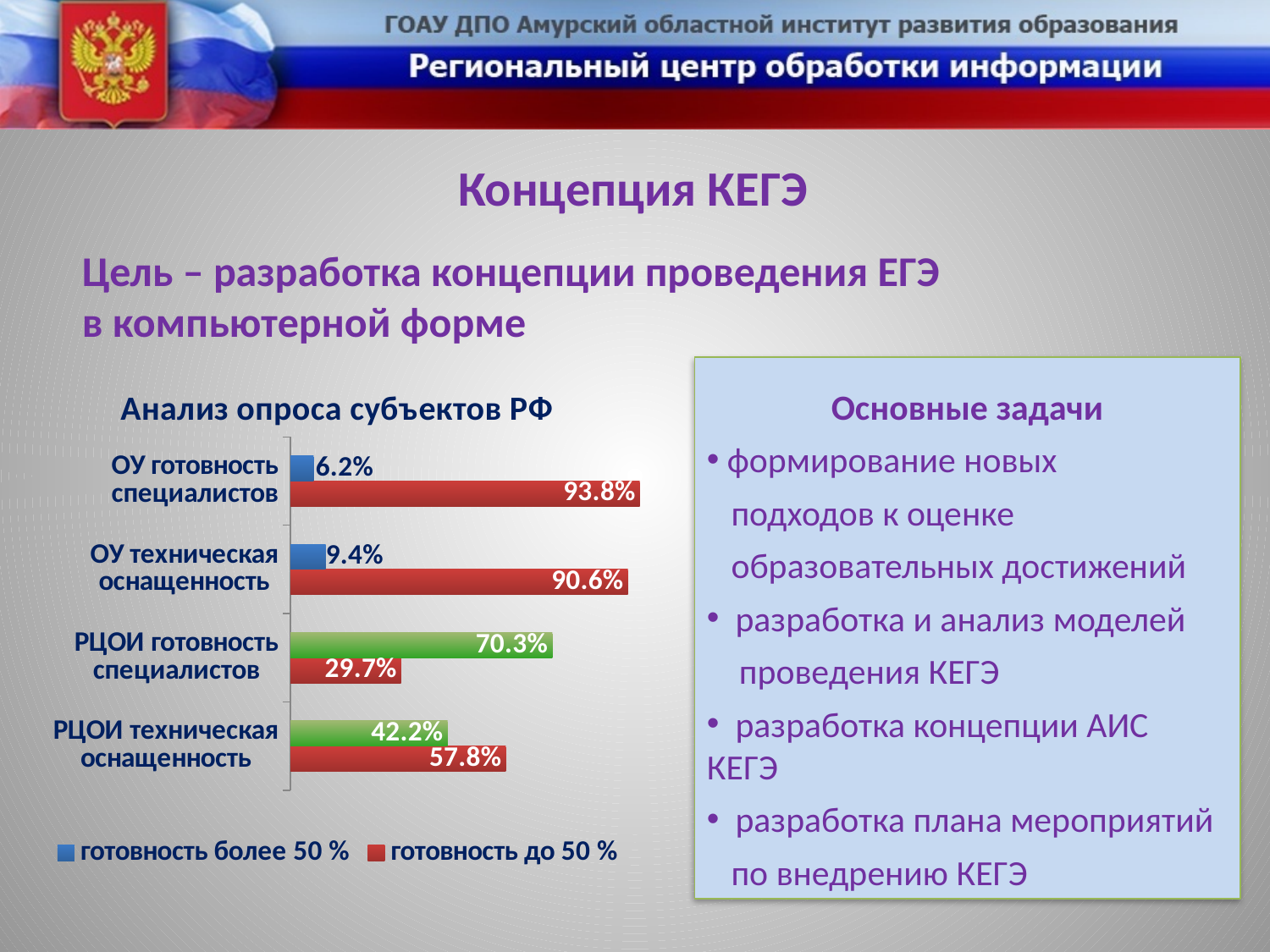
Which category has the highest value for "готовность до 50 %"? ОУ готовность специалистов Which is larger for "РЦОИ готовность специалистов": the "готовность более 50 %" value or the "готовность до 50 %" value? готовность более 50 % What colour is the "готовность до 50 %" series in the legend? red Which category has the lowest value for "готовность более 50 %"? ОУ готовность специалистов What is the value of "готовность до 50 %" for "РЦОИ готовность специалистов"? 29.7% How many categories are shown in the chart "Анализ опроса субъектов РФ"? 4 What type of chart is shown under the title "Анализ опроса субъектов РФ"? bar chart How many series does the legend of the chart list? 2 What is the difference between the "готовность до 50 %" values for "ОУ техническая оснащенность" and "РЦОИ техническая оснащенность"? 32.8% What is the value of the upper (green) bar for "РЦОИ техническая оснащенность"? 42.2% What is the value of "готовность до 50 %" for "ОУ готовность специалистов"? 93.8% What is the value of "готовность более 50 %" for "ОУ техническая оснащенность"? 9.4%